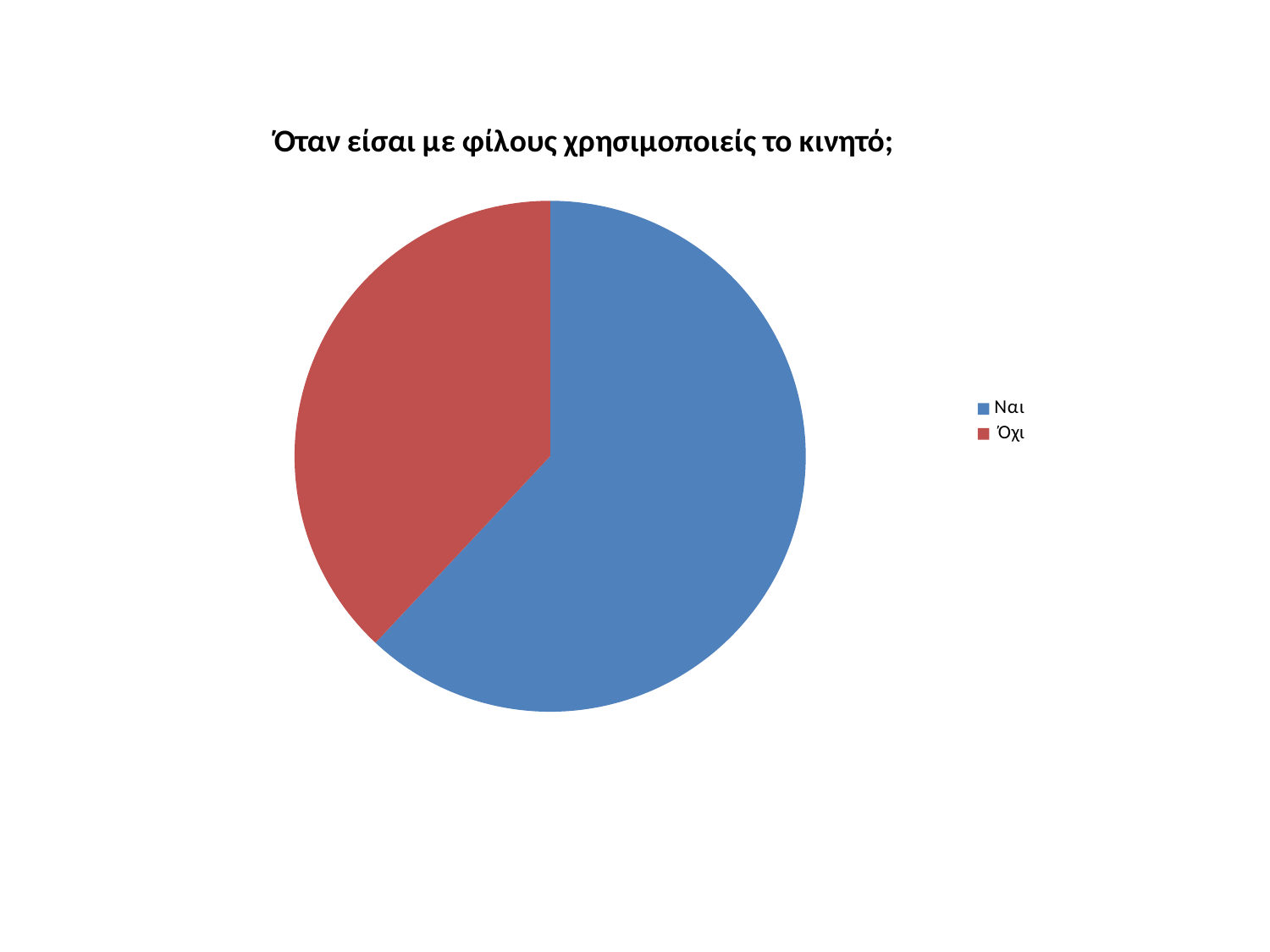
Does the Ναι slice take up more or less than half of the pie? more How many slices does the pie chart have? 2 Which slice is larger, Ναι or Όχι? Ναι How many entries does the legend list? 2 What kind of chart is shown on the slide? pie chart Which category has the smallest slice of the pie? Όχι What is the title of the chart? Όταν είσαι με φίλους χρησιμοποιείς το κινητό; Which category has the largest slice of the pie? Ναι What colour is the slice for Ναι? blue